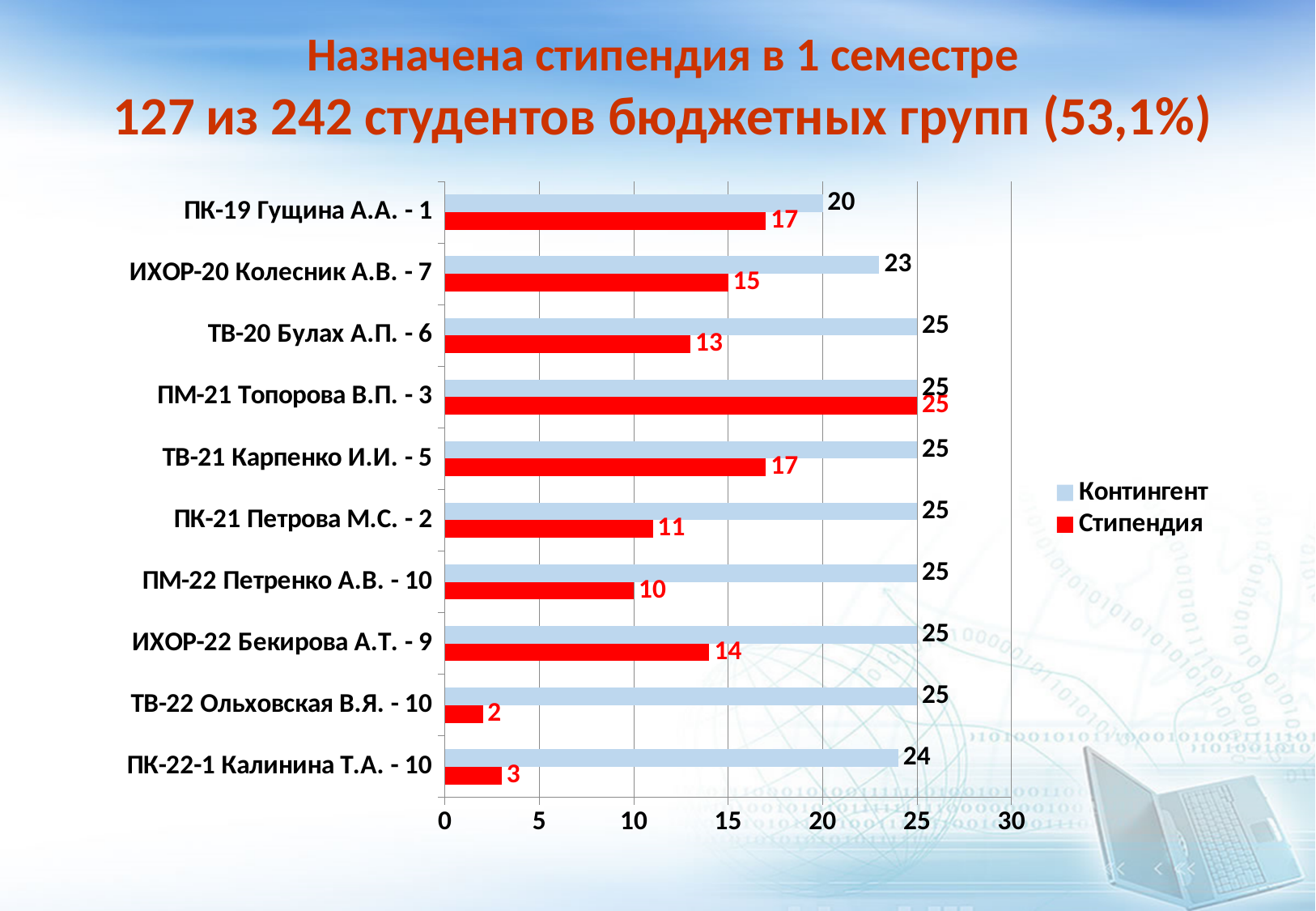
Which category has the highest Стипендия value? ПМ-21 Топорова В.П. - 3 What is the Стипендия value for ПМ-21 Топорова В.П. - 3? 25 How many categories are shown on the chart? 10 What is the Контингент value for ИХОР-20 Колесник А.В. - 7? 23 Which category has the lowest Стипендия value? ТВ-22 Ольховская В.Я. - 10 What is the Стипендия value for ТВ-22 Ольховская В.Я. - 10? 2 Which is larger: the Стипендия value for ТВ-21 Карпенко И.И. - 5 or for ИХОР-22 Бекирова А.Т. - 9? ТВ-21 Карпенко И.И. - 5 Which colour represents the Стипендия series? Red What kind of chart is shown on the slide? Bar chart How many series does the legend list? 2 Which category has the lowest Контингент value? ПК-19 Гущина А.А. - 1 What is the difference between the Контингент and Стипендия values for ПК-21 Петрова М.С. - 2? 14